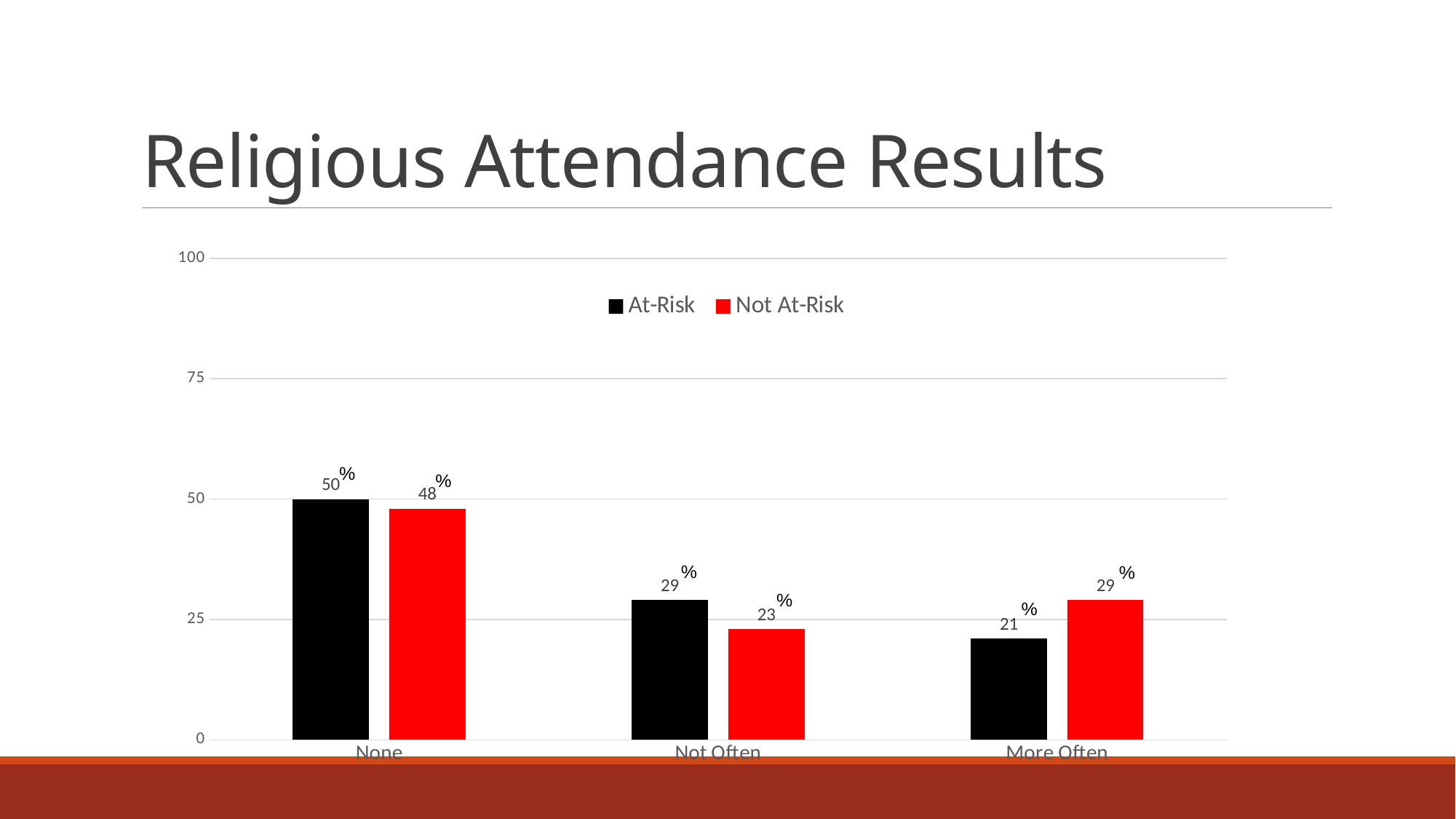
How many series does the legend list? 2 What is the At-Risk value for None? 50% Is the Not At-Risk value for None greater or less than 25? greater How many categories are shown on the x axis? 3 What is the At-Risk value for More Often? 21% What is the Not At-Risk value for Not Often? 23% What is the Not At-Risk value for More Often? 29% What is the difference between the At-Risk and Not At-Risk values for Not Often? 6% Which category has the lowest Not At-Risk value? Not Often What kind of chart is shown on the slide? Bar chart For More Often, which is larger: At-Risk or Not At-Risk? Not At-Risk Which category has the highest At-Risk value? None